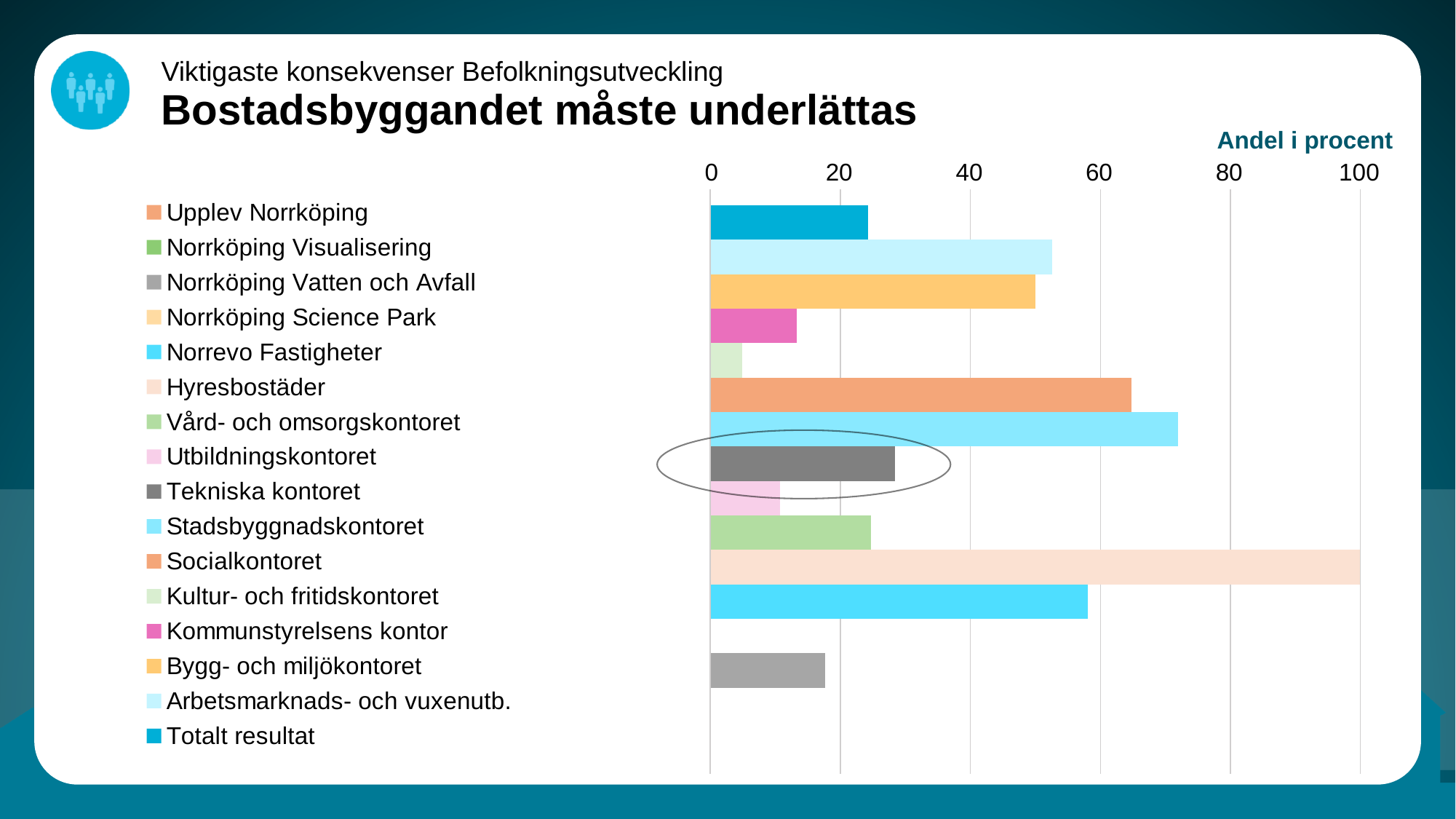
Which has the larger value, Socialkontoret or Stadsbyggnadskontoret? Stadsbyggnadskontoret Is the value for Kultur- och fritidskontoret greater or less than 20? less How many entries does the legend list? 16 Is the value for Bygg- och miljökontoret greater or less than 40? greater Is the value for Socialkontoret greater or less than 60? greater What value does the bar for Hyresbostäder reach on the axis? 100 Which legend entry has the longest bar in the chart? Hyresbostäder What kind of chart is shown on the slide? bar chart What label is shown above the horizontal axis of the chart? Andel i procent Which has the larger value, Tekniska kontoret or Utbildningskontoret? Tekniska kontoret